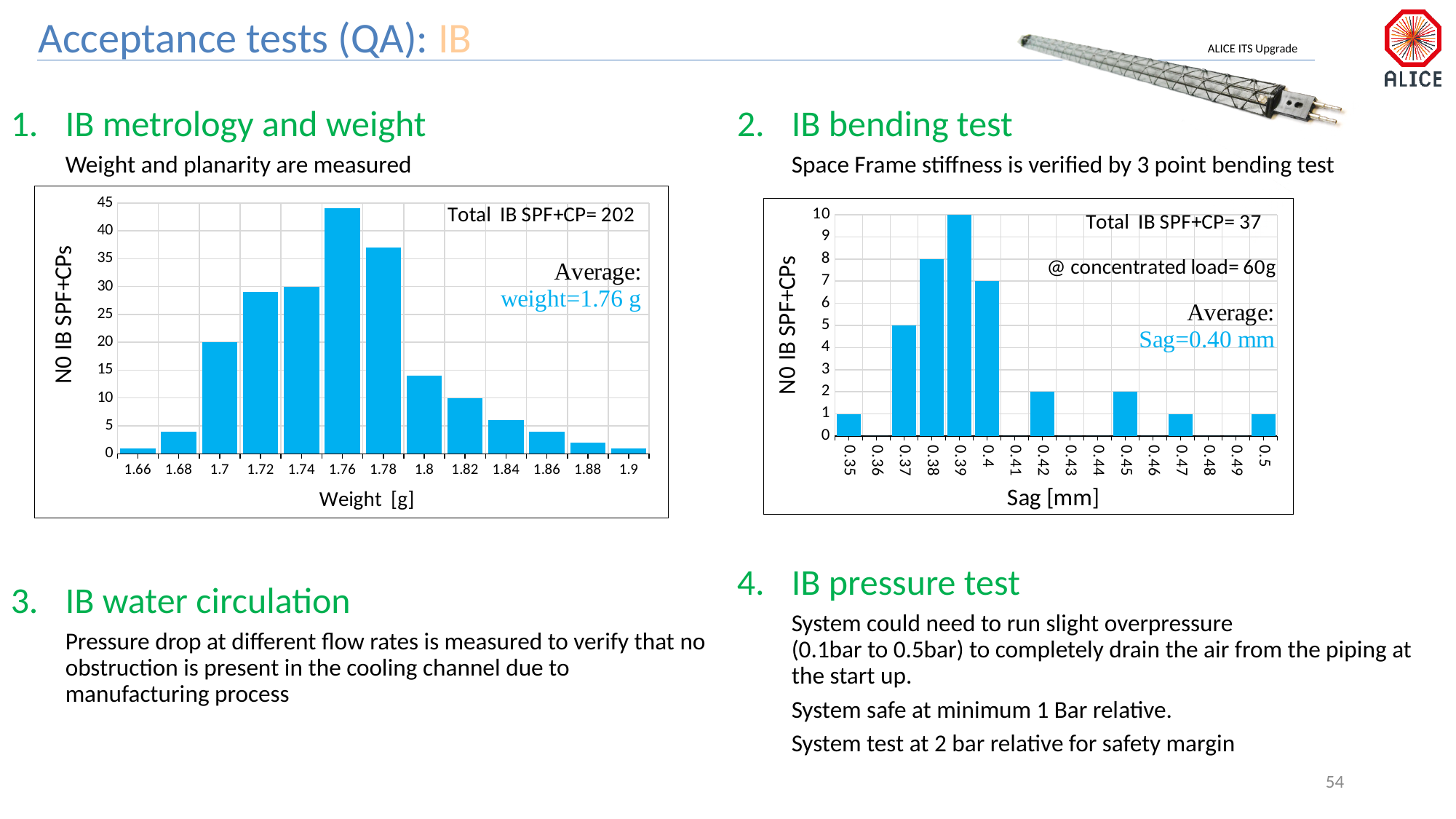
How many weight bins are shown on the x axis of the Weight [g] chart? 13 In the Sag [mm] chart, which sag bin has the highest count? 0.39 In the Sag [mm] chart, what is the difference between the values for the 0.39 and 0.37 bins? 5 In the Weight [g] chart, is the value for the 1.76 bin greater or less than 40? greater In the Sag [mm] chart, what is the value for the 0.38 bin? 8 What total is stated in the annotation on the Weight [g] chart? Total IB SPF+CP= 202 In the Weight [g] chart, which is larger, the value for 1.78 or the value for 1.8? 1.78 What average sag is stated on the Sag [mm] chart? Sag=0.40 mm In the Weight [g] chart, what is the value for the 1.7 bin? 20 In the Weight [g] chart, which weight bin has the highest count? 1.76 What kind of chart is the Sag [mm] chart? bar chart In the Sag [mm] chart, what is the value for the 0.4 bin? 7